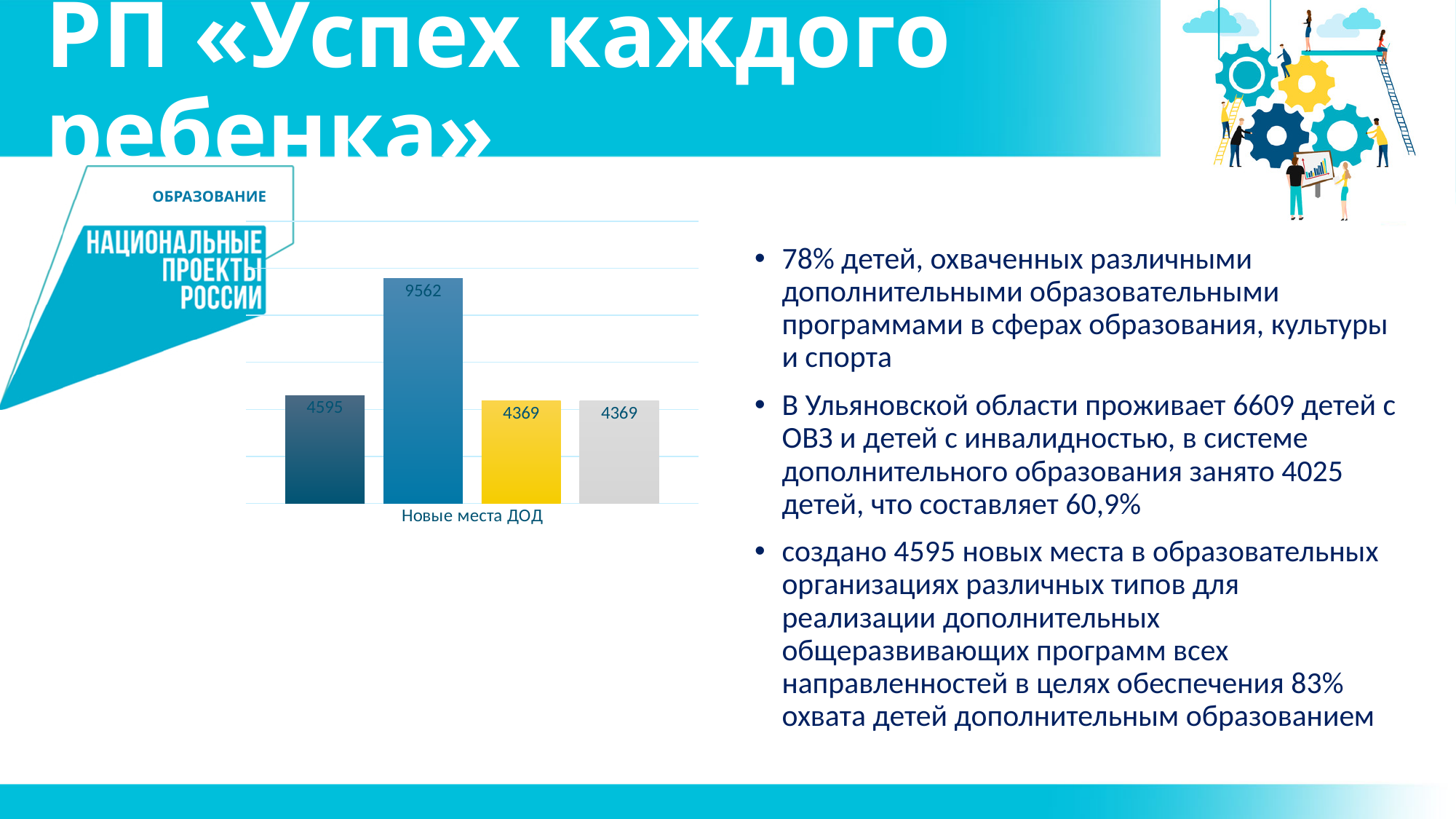
How many bars are plotted in the chart? 4 What is the value of the tallest bar in the chart? 9562 Which is larger in the chart: the first dark blue bar or the second blue bar? the second blue bar What is the value of the second (blue) bar in the chart? 9562 What is the difference between the second bar (9562) and the first bar (4595) in the chart? 4967 What is the lowest value shown among the bars in the chart? 4369 What is the value of the first (leftmost, dark blue) bar in the chart? 4595 What kind of chart is shown on the slide? bar chart What is the value of the grey (rightmost) bar in the chart? 4369 What is the category label shown on the x axis of the chart? Новые места ДОД What is the difference between the first bar (4595) and the yellow bar (4369) in the chart? 226 What is the value of the yellow bar in the chart? 4369